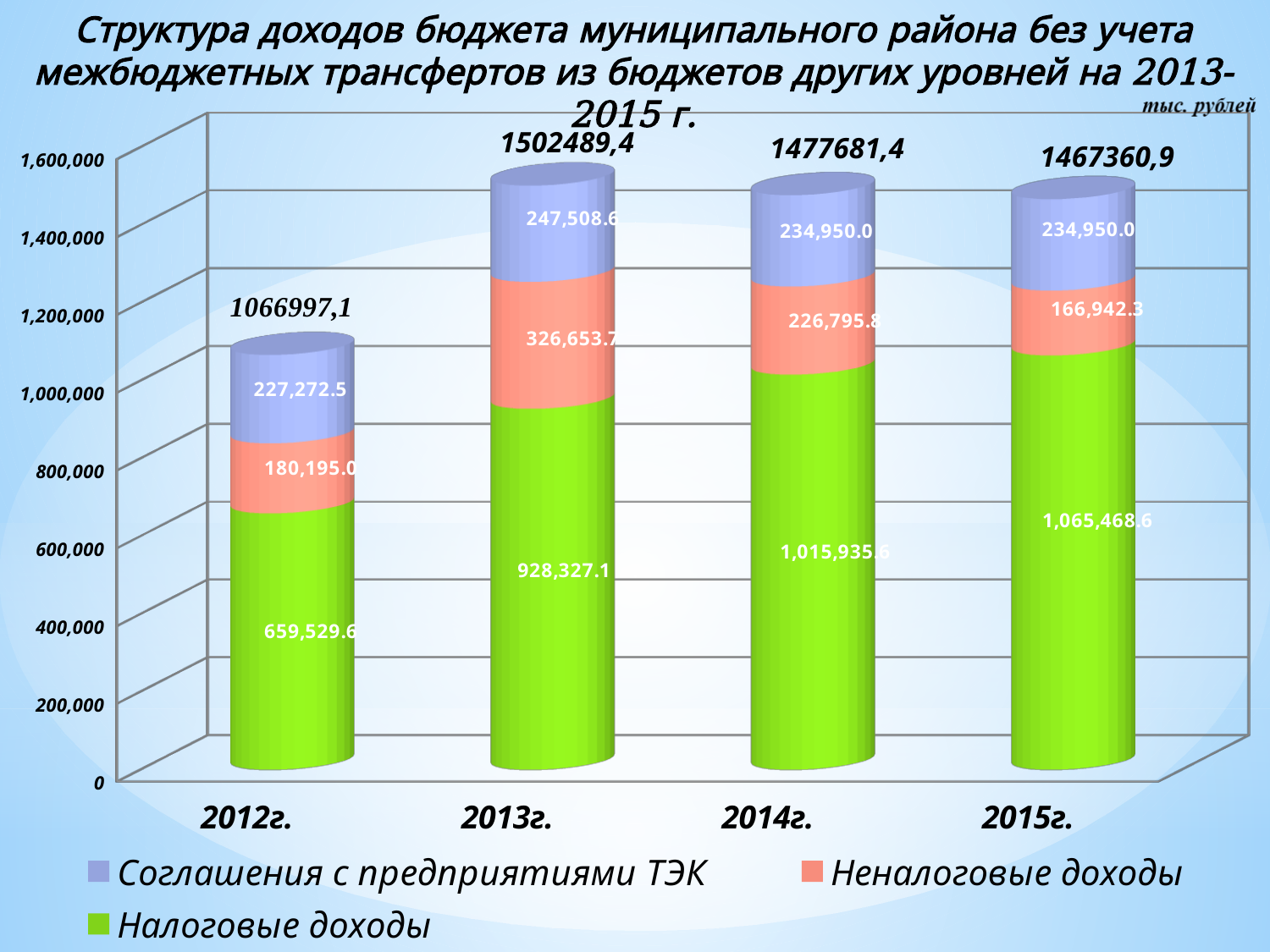
How many series does the legend list? 3 Which year has the highest value of Налоговые доходы? 2015г. What is the total printed above the bar for 2013г.? 1502489,4 How many years are shown on the x axis? 4 What is the value of Соглашения с предприятиями ТЭК for 2015г.? 234,950.0 What is the difference between Налоговые доходы in 2015г. and 2014г.? 49,533.0 Which is larger: Неналоговые доходы in 2014г. or Соглашения с предприятиями ТЭК in 2014г.? Соглашения с предприятиями ТЭК in 2014г. Which year has the lowest value of Неналоговые доходы? 2015г. What is the value of Налоговые доходы for 2012г.? 659,529.6 What kind of chart is shown on the slide? Stacked bar chart Which colour represents Налоговые доходы in the legend? Green What is the value of Неналоговые доходы for 2013г.? 326,653.7